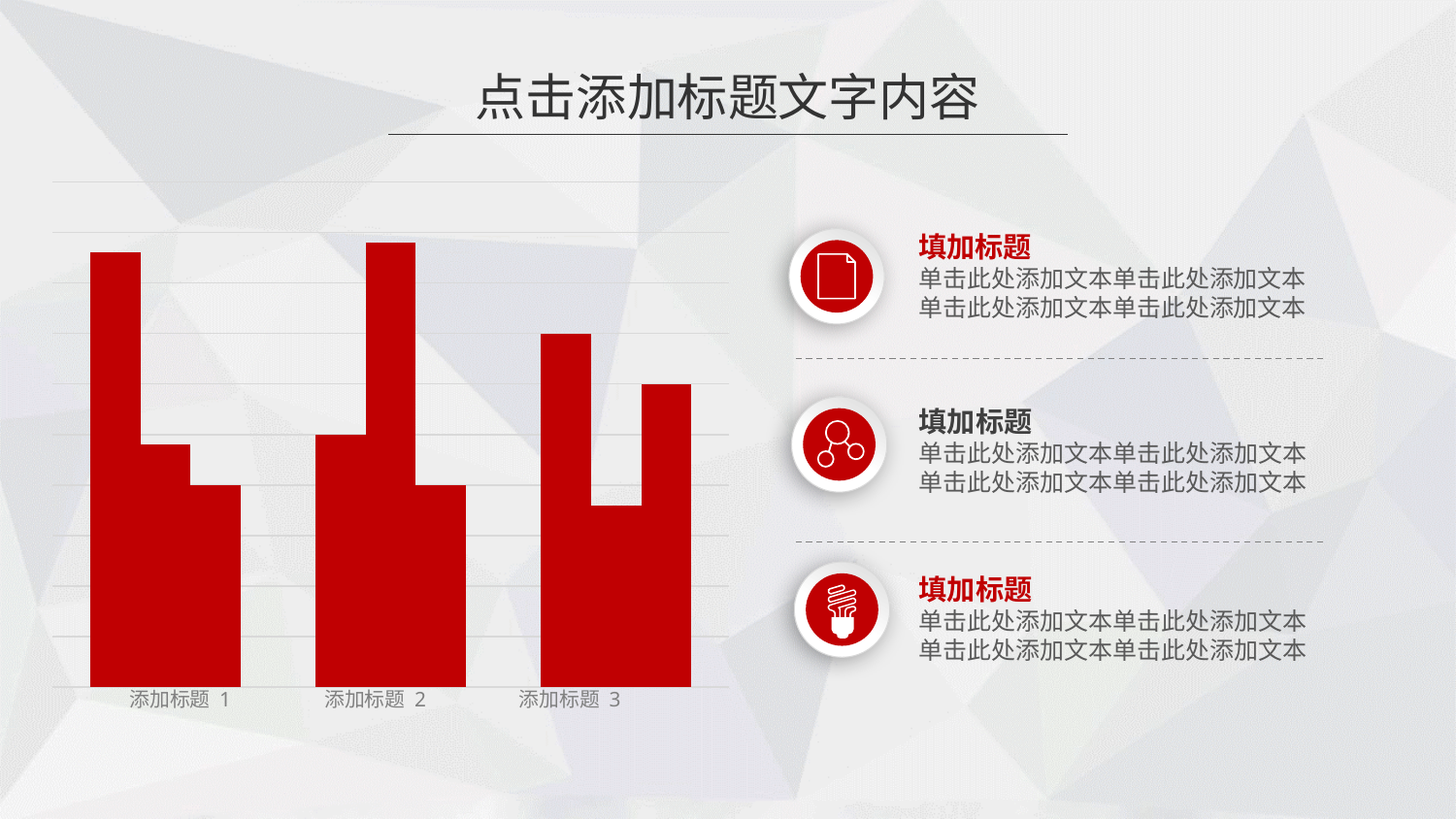
Within the category 添加标题 1, which bar is the shortest: the first, second or third? The third Within the category 添加标题 2, which bar is the tallest: the first, second or third? The second Which is taller: the first bar of 添加标题 1 or the first bar of 添加标题 2? The first bar of 添加标题 1 Within the category 添加标题 1, which bar is the tallest: the first, second or third? The first Which is taller: the first bar of 添加标题 3 or the third bar of 添加标题 3? The first bar of 添加标题 3 What colour are the bars in the chart? Red What is the label of the first category on the x axis of the bar chart? 添加标题 1 Within the category 添加标题 3, which bar is the shortest: the first, second or third? The second How many bars are plotted for each category in the bar chart? 3 How many categories are shown along the x axis of the bar chart? 3 What kind of chart is shown on the left of the slide? Bar chart